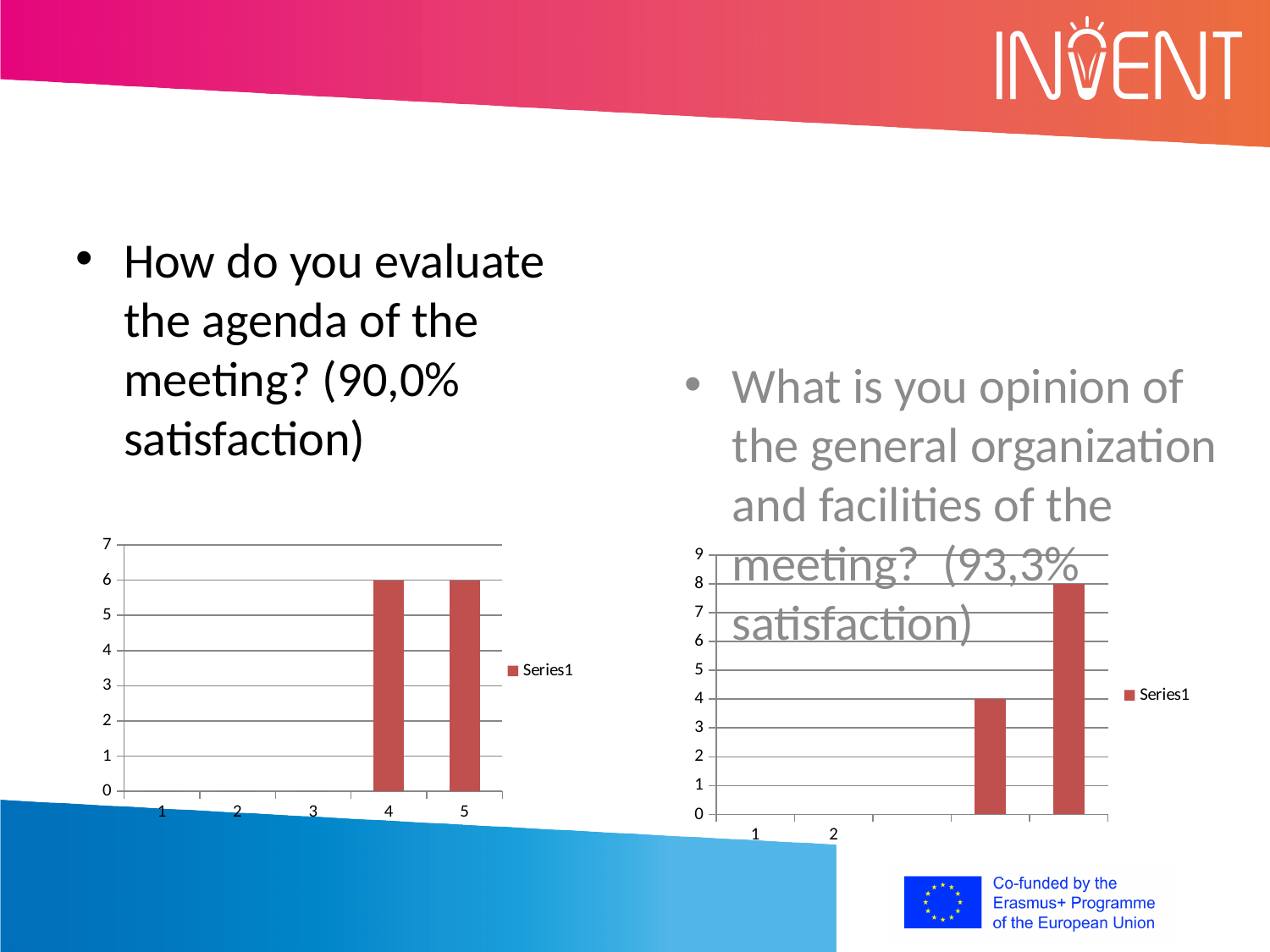
On the left chart, what is the value for category 1? 0 On the right chart, what is the highest value shown on the vertical axis? 9 On the right chart, what is the value of the tallest bar? 8 On the left chart, how many categories are shown on the x axis? 5 On the right chart, what is the difference between the tallest bar and the shorter bar? 4 On the left chart, what is the value for category 5? 6 What kind of chart is the left chart? bar chart On the right chart, what is the value of the shorter of the two bars? 4 On the left chart, what is the name of the series in the legend? Series1 On the left chart, how many series does the legend list? 1 On the left chart, what is the value for category 4? 6 On the right chart, how many series does the legend list? 1